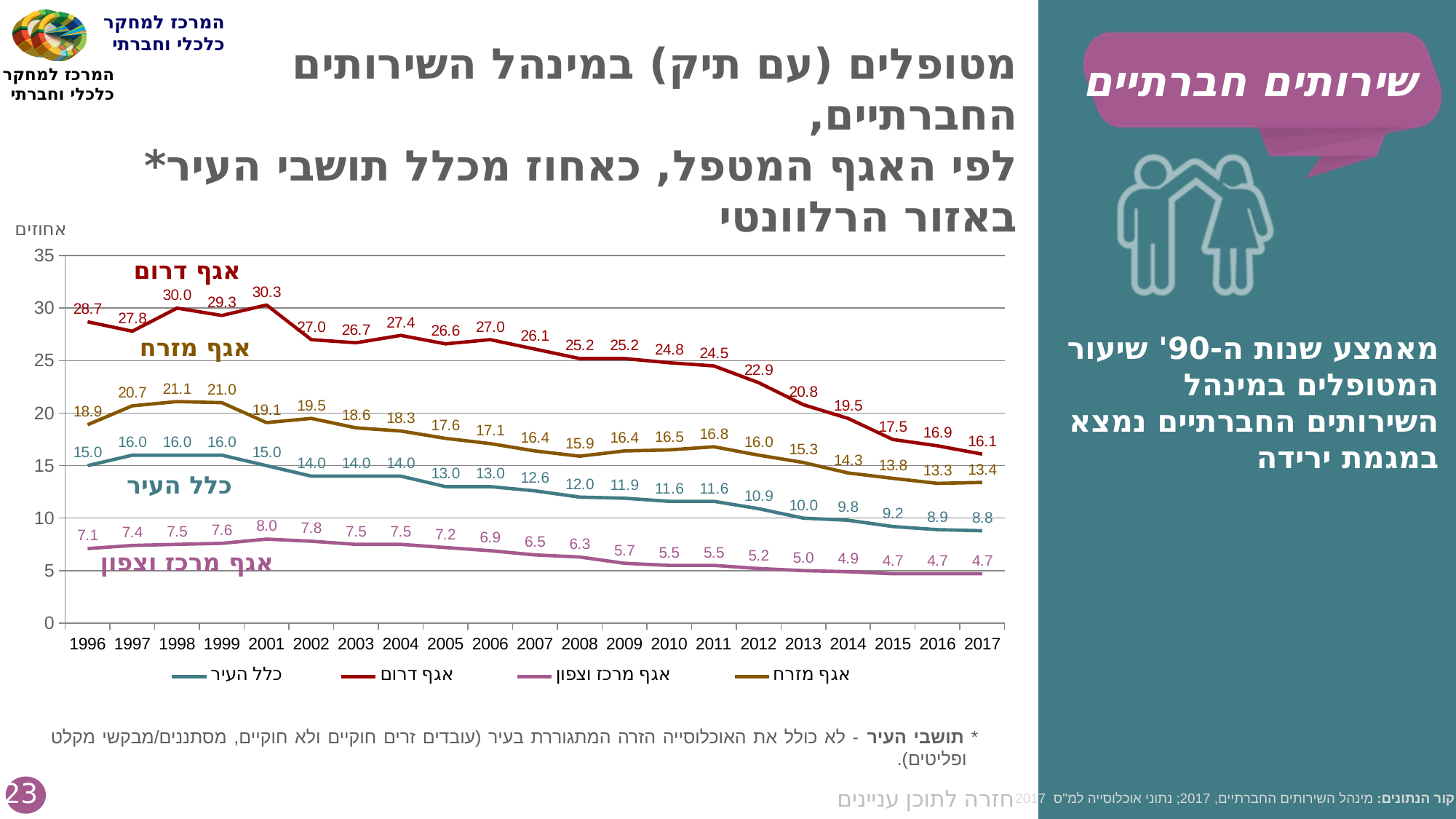
How many years are plotted along the x axis? 21 Which is larger in 2011: the value for אגף מזרח or the value for כלל העיר? אגף מזרח In which year does אגף דרום reach its highest value? 2001 How many series does the legend list? 4 Which series has the lowest value in 2017? אגף מרכז וצפון What is the overall trend of the כלל העיר series from 1996 to 2017? falling What is the value for אגף מרכז וצפון in 2009? 5.7 What is the value for כלל העיר in 2017? 8.8 What is the value for אגף דרום in 2001? 30.3 What is the difference between אגף דרום and אגף מזרח in 1996? 9.8 What is the value for אגף מזרח in 1998? 21.1 What type of chart is shown on the slide? line chart